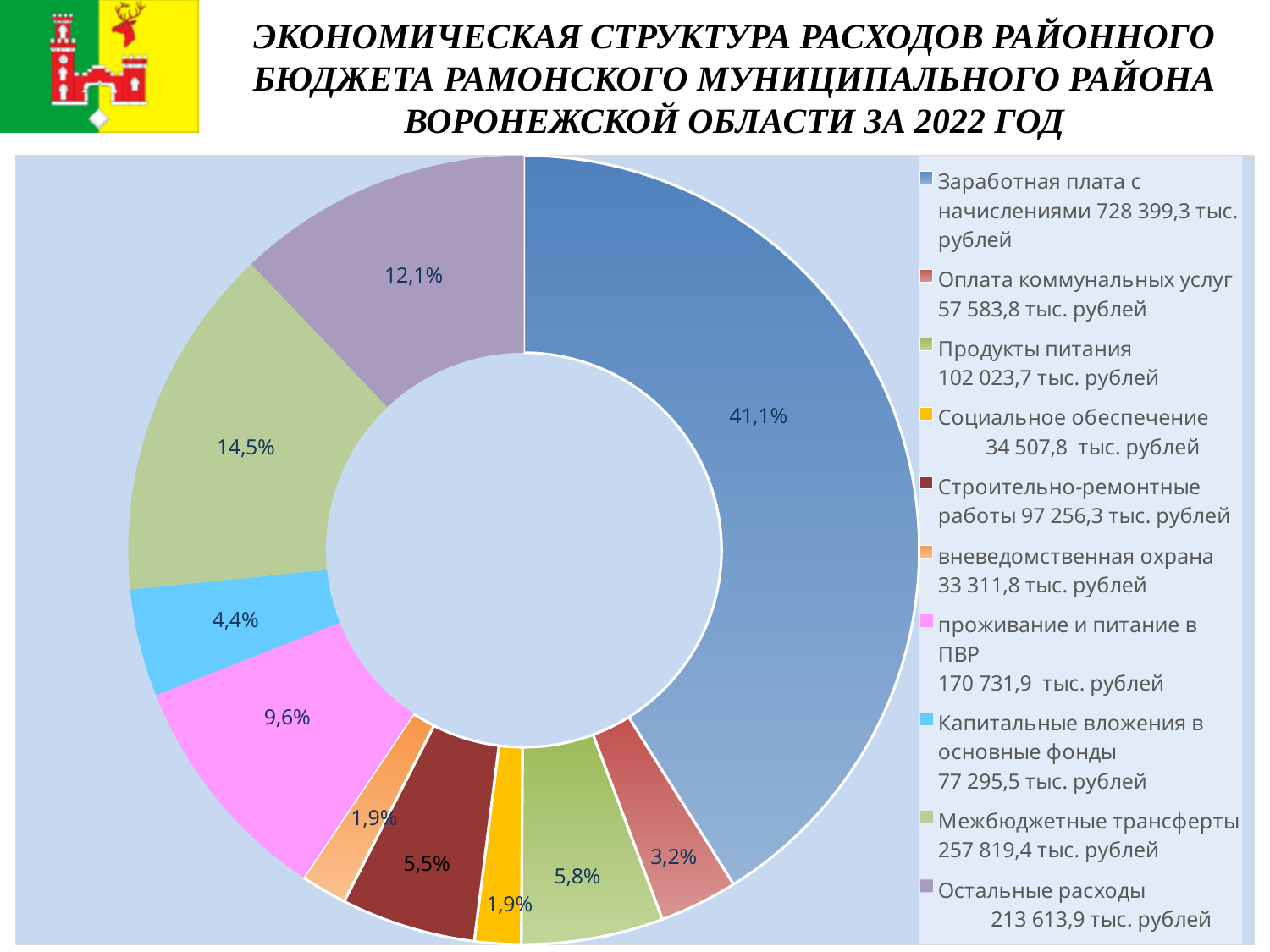
How many categories does the chart show? 10 What percentage is shown for Остальные расходы? 12,1% What kind of chart is shown on the slide? Doughnut chart What percentage is shown for Межбюджетные трансферты? 14,5% Which category has the larger share: Продукты питания or Строительно-ремонтные работы? Продукты питания What is the difference in percentage points between Межбюджетные трансферты and Остальные расходы? 2,4 Which category has the larger share: Оплата коммунальных услуг or Социальное обеспечение? Оплата коммунальных услуг What share of the chart does Заработная плата с начислениями account for? 41,1% What percentage is shown for проживание и питание в ПВР? 9,6% Which category has the largest share of the chart? Заработная плата с начислениями What percentage is shown for Капитальные вложения в основные фонды? 4,4% According to the legend, what amount in thousand rubles is given for Оплата коммунальных услуг? 57 583,8 тыс. рублей